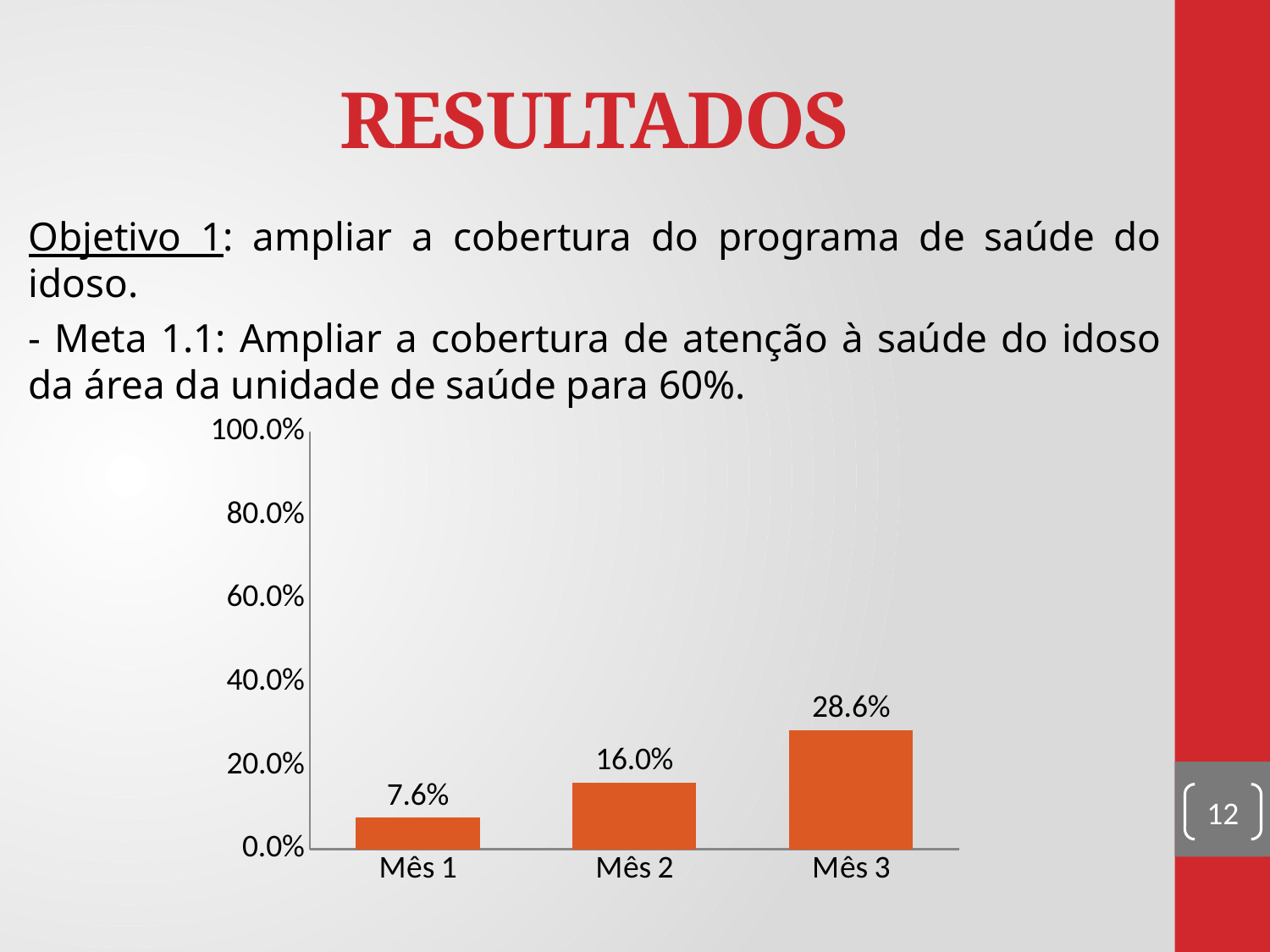
Which is larger, the value for Mês 2 or the value for Mês 3? Mês 3 What is the value for Mês 3? 28.6% Which month has the lowest value? Mês 1 What is the difference between the values for Mês 3 and Mês 1? 21.0% What kind of chart is shown on the slide? bar chart What is the difference between the values for Mês 2 and Mês 1? 8.4% What is the value for Mês 1? 7.6% How many categories are shown on the x axis? 3 What is the value for Mês 2? 16.0% Is the value for Mês 3 greater or less than 40.0%? less Do the values rise or fall from Mês 1 to Mês 3? rise Which month has the highest value? Mês 3